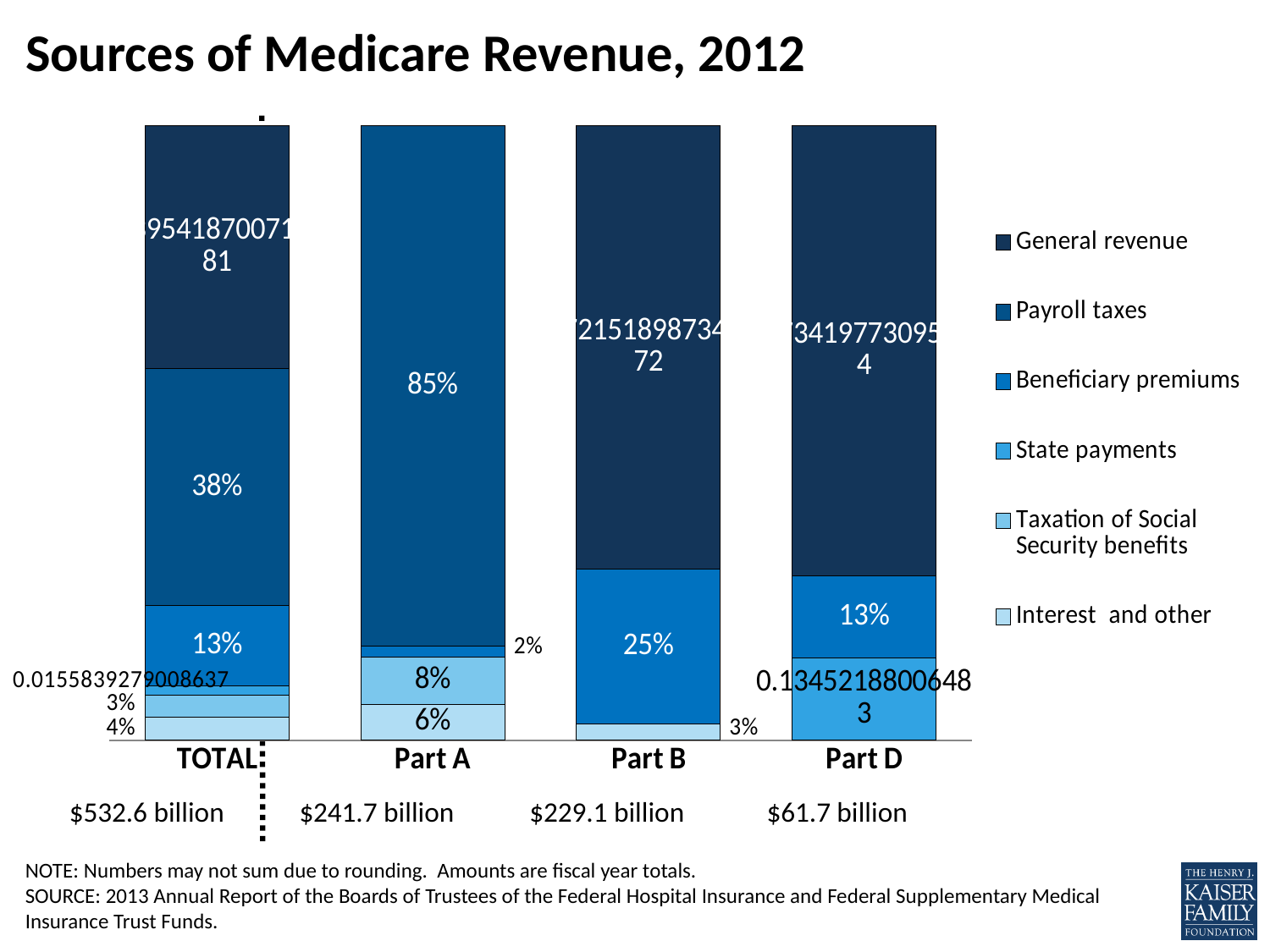
What total revenue amount is shown beneath the Part A bar? $241.7 billion How many bars (categories) are shown on the x axis? 4 How many series does the legend list? 6 What kind of chart is shown on the slide? Stacked bar chart What share of Part A revenue comes from interest and other? 6% What share of Part D revenue comes from beneficiary premiums? 13% What share of Part A revenue comes from payroll taxes? 85% What share of TOTAL Medicare revenue comes from payroll taxes? 38% Which has a larger beneficiary premiums share, Part B or Part D? Part B What share of Part B revenue comes from beneficiary premiums? 25% What share of Part A revenue comes from taxation of Social Security benefits? 8% By how many percentage points does the payroll taxes share for Part A exceed the payroll taxes share for TOTAL? 47 percentage points